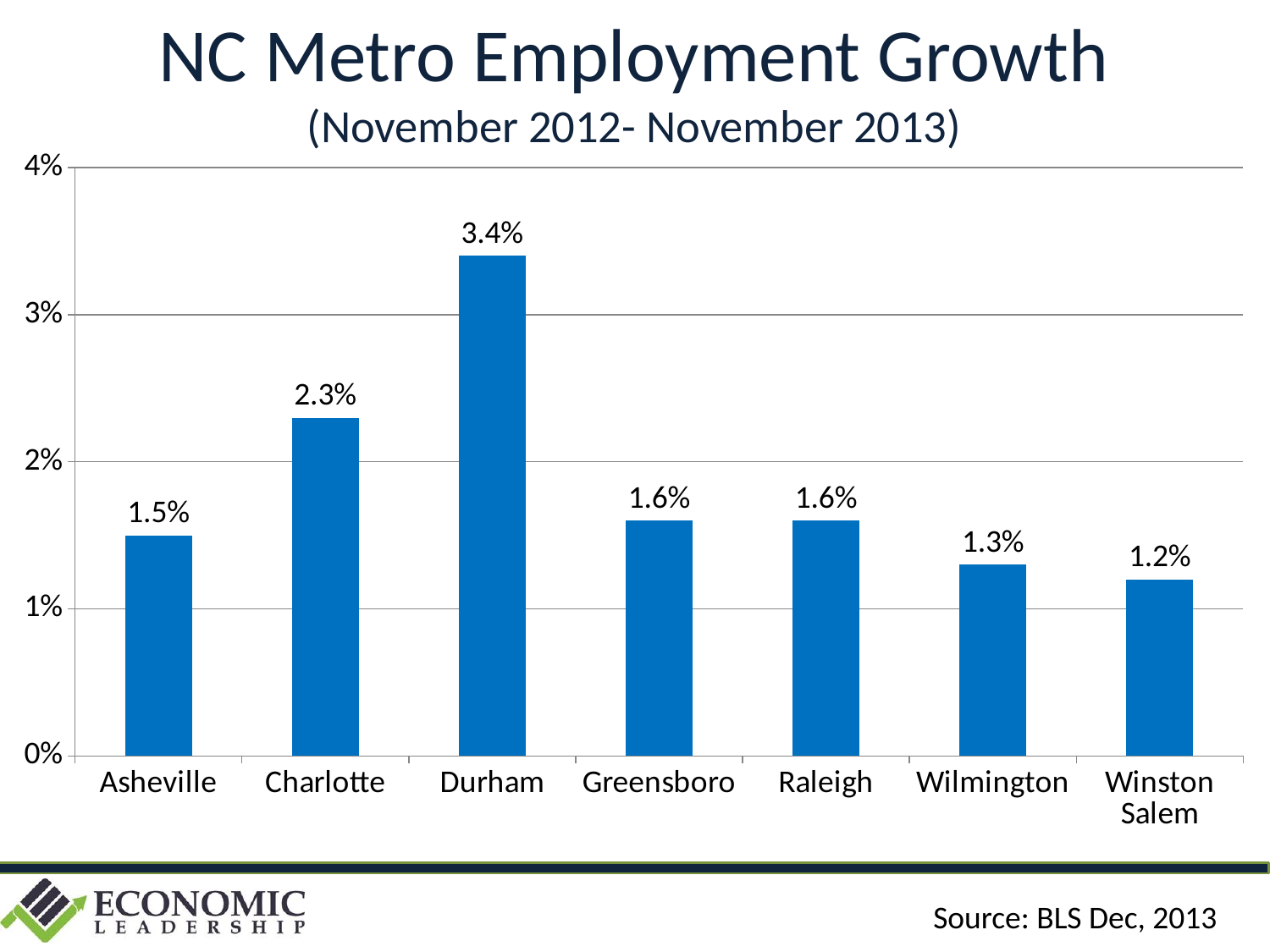
What is the employment growth value for Durham? 3.4% What is the employment growth value for Winston Salem? 1.2% Which metro area has the lowest employment growth? Winston Salem What kind of chart is shown on the slide? Bar chart What is the difference in employment growth between Asheville and Winston Salem? 0.3% What is the difference in employment growth between Durham and Charlotte? 1.1% What is the employment growth value for Wilmington? 1.3% Is the value for Durham greater or less than 3%? greater Which metro area has the highest employment growth? Durham Which has higher employment growth, Charlotte or Raleigh? Charlotte What is the employment growth value for Charlotte? 2.3% How many metro areas are shown in the chart? 7